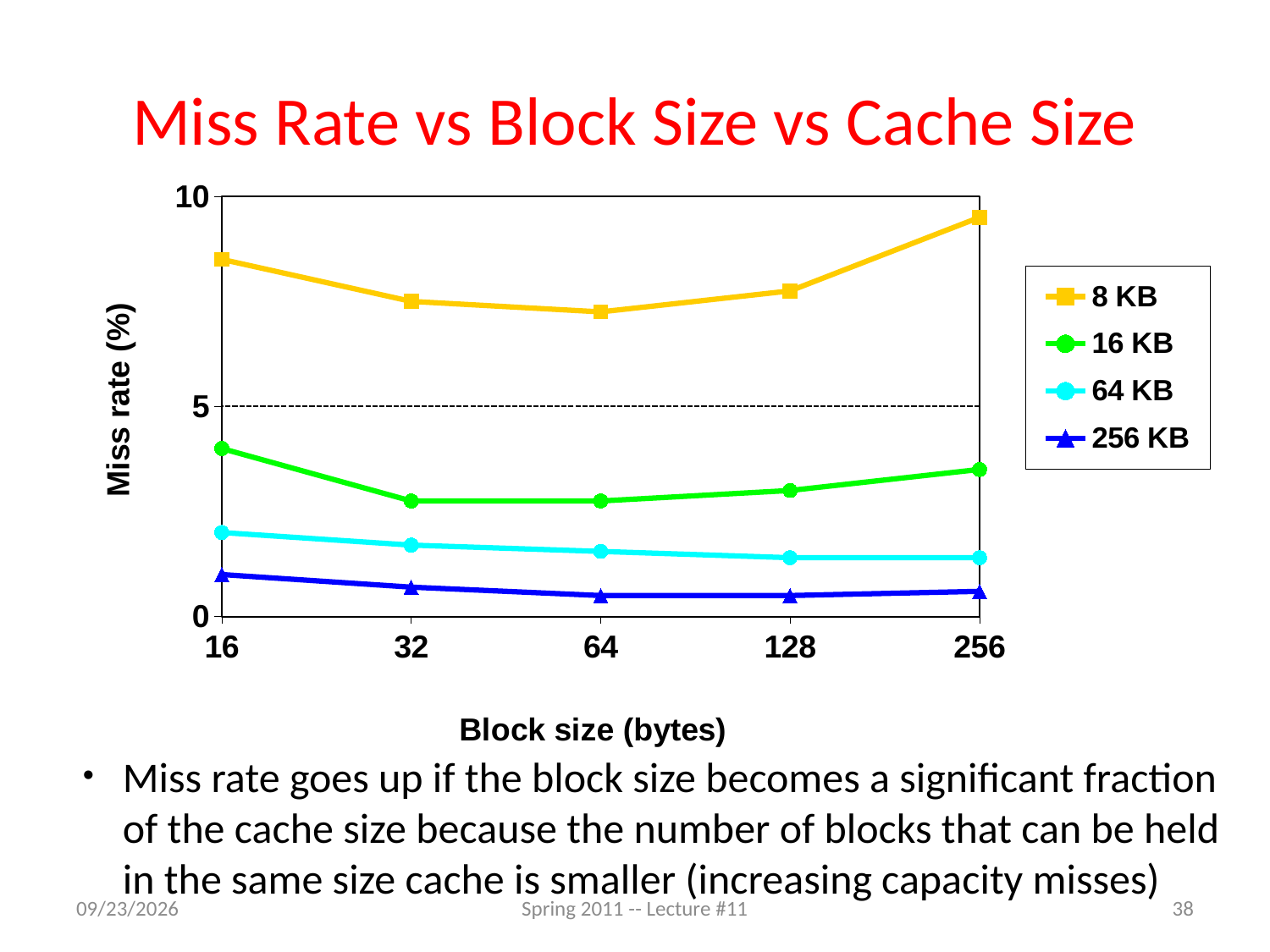
For the 8 KB cache, is the miss rate larger at a block size of 64 bytes or 256 bytes? 256 bytes Which cache size series has the highest miss rate at a block size of 256 bytes? 8 KB Which cache size series has the lowest miss rate across all block sizes? 256 KB What is the label on the x axis of the chart? Block size (bytes) How many series does the legend list? 4 What kind of chart is shown on the slide? line chart Is the miss rate for the 16 KB cache at a block size of 16 bytes greater or less than 5? less Does the miss rate for the 256 KB cache rise or fall as block size goes from 16 to 64 bytes? fall How many block sizes are plotted along the x axis? 5 What is the label on the y axis of the chart? Miss rate (%) Is the miss rate for the 8 KB cache at a block size of 16 bytes greater or less than 5? greater For the 16 KB cache, is the miss rate larger at a block size of 16 bytes or 32 bytes? 16 bytes